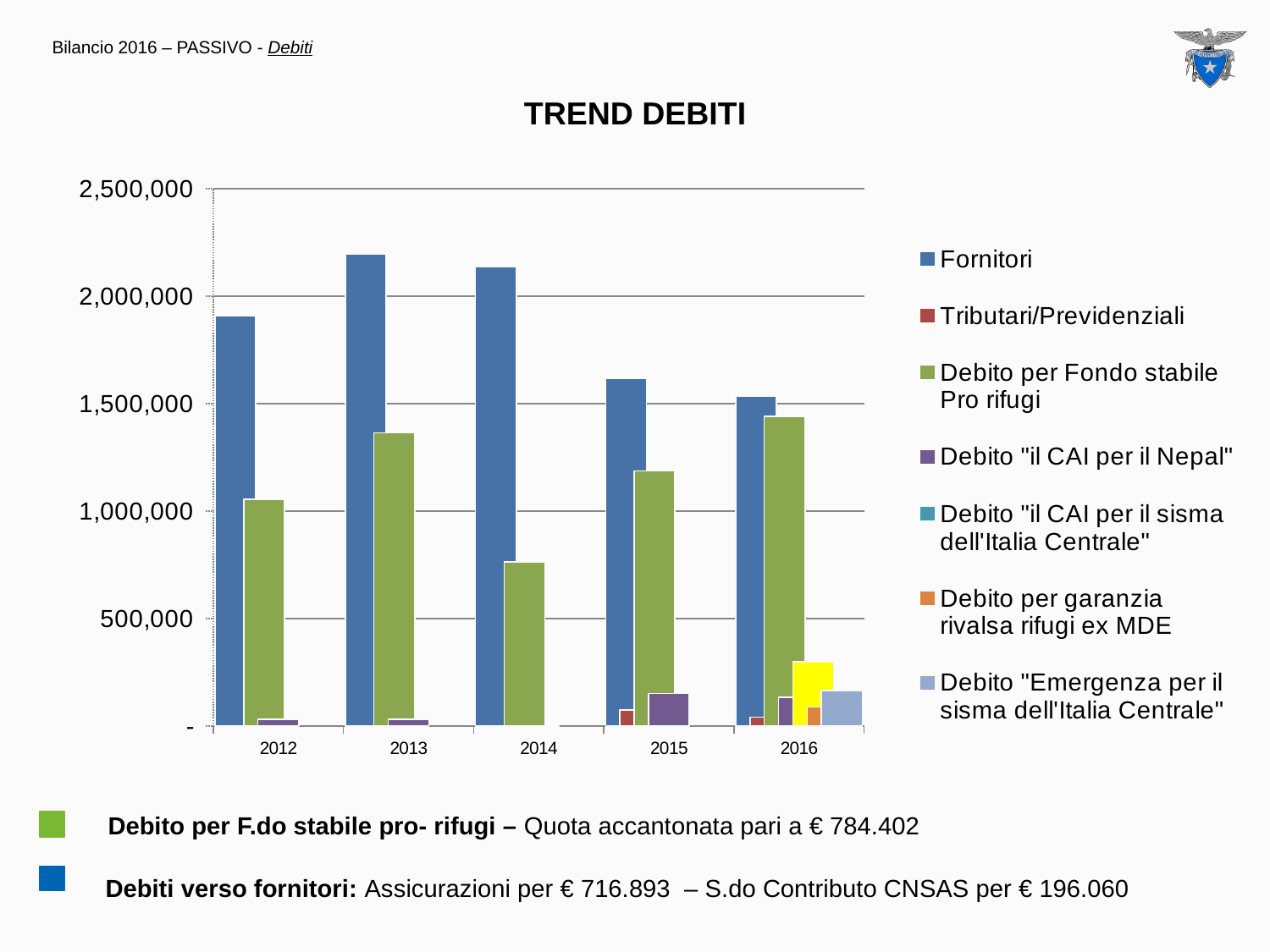
In which year is the Debito per Fondo stabile Pro rifugi bar lowest? 2014 Is the value for Debito per Fondo stabile Pro rifugi in 2014 greater or less than 1,000,000? less How many series does the chart's legend list? 7 In which year is the Fornitori bar highest? 2013 Is the value for Fornitori in 2014 greater or less than 2,000,000? greater Is the value for Fornitori in 2012 greater or less than 1,500,000? greater What is the title of the chart? TREND DEBITI How many years are shown on the x axis of the chart? 5 In 2016, which is larger: Fornitori or Debito per Fondo stabile Pro rifugi? Fornitori What kind of chart is shown on the slide? bar chart In which year is the Fornitori bar lowest? 2016 Do the Fornitori values rise or fall from 2013 to 2016? fall